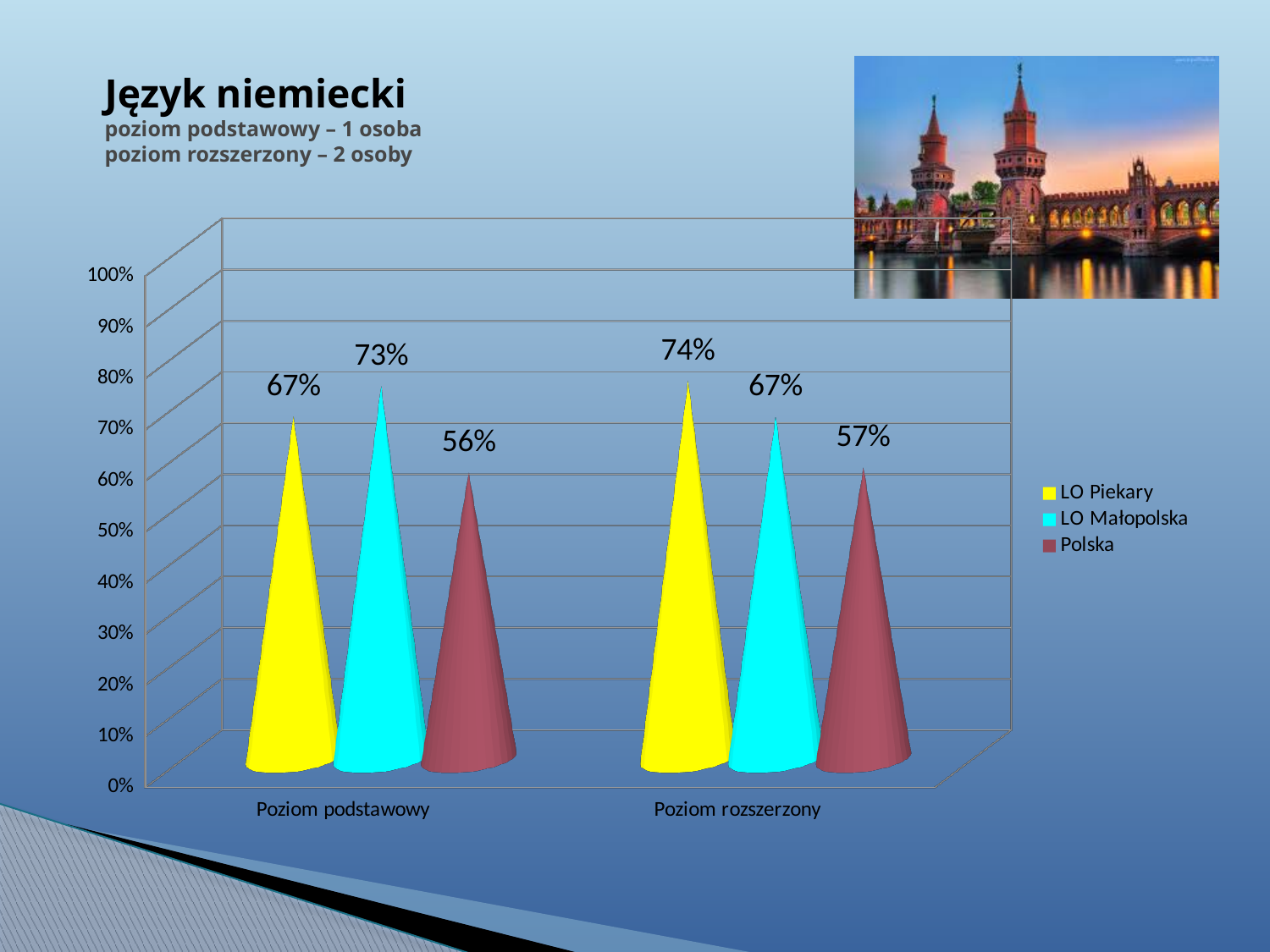
How many categories are shown on the x axis? 2 What is the value for Polska at Poziom rozszerzony? 57% What is the value for LO Małopolska at Poziom podstawowy? 73% Which colour represents Polska in the legend? maroon What is the value for LO Piekary at Poziom rozszerzony? 74% What is the difference between LO Małopolska and Polska at Poziom podstawowy? 17% How many series does the legend list? 3 What is the value for LO Piekary at Poziom podstawowy? 67% Which is larger: LO Piekary at Poziom podstawowy or LO Piekary at Poziom rozszerzony? Poziom rozszerzony Which series has the lowest value at Poziom rozszerzony? Polska Which series has the highest value at Poziom podstawowy? LO Małopolska What kind of chart is shown on the slide? bar chart